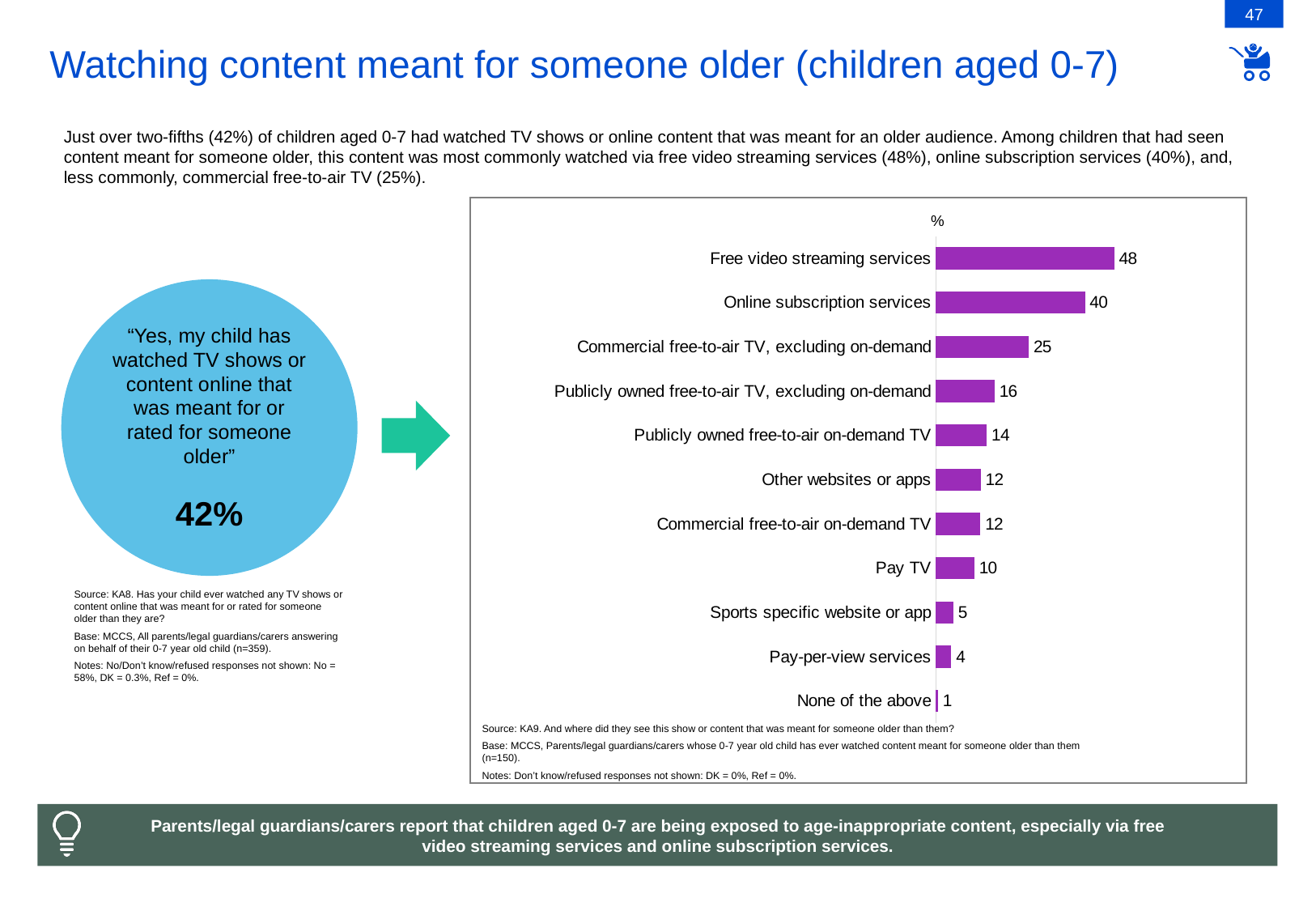
What is the difference between the values for Publicly owned free-to-air on-demand TV and Other websites or apps? 2 What colour are the bars in the chart? Purple What is the value for Sports specific website or app? 5 What is the value for Free video streaming services? 48 What is the difference between the values for Free video streaming services and Online subscription services? 8 What is the value for Commercial free-to-air TV, excluding on-demand? 25 Which is larger, the value for Publicly owned free-to-air TV, excluding on-demand or the value for Pay-per-view services? Publicly owned free-to-air TV, excluding on-demand Which category has the lowest value? None of the above What kind of chart is shown on the slide? Bar chart What is the value for Pay TV? 10 Which category has the highest value? Free video streaming services How many categories are shown in the bar chart? 11